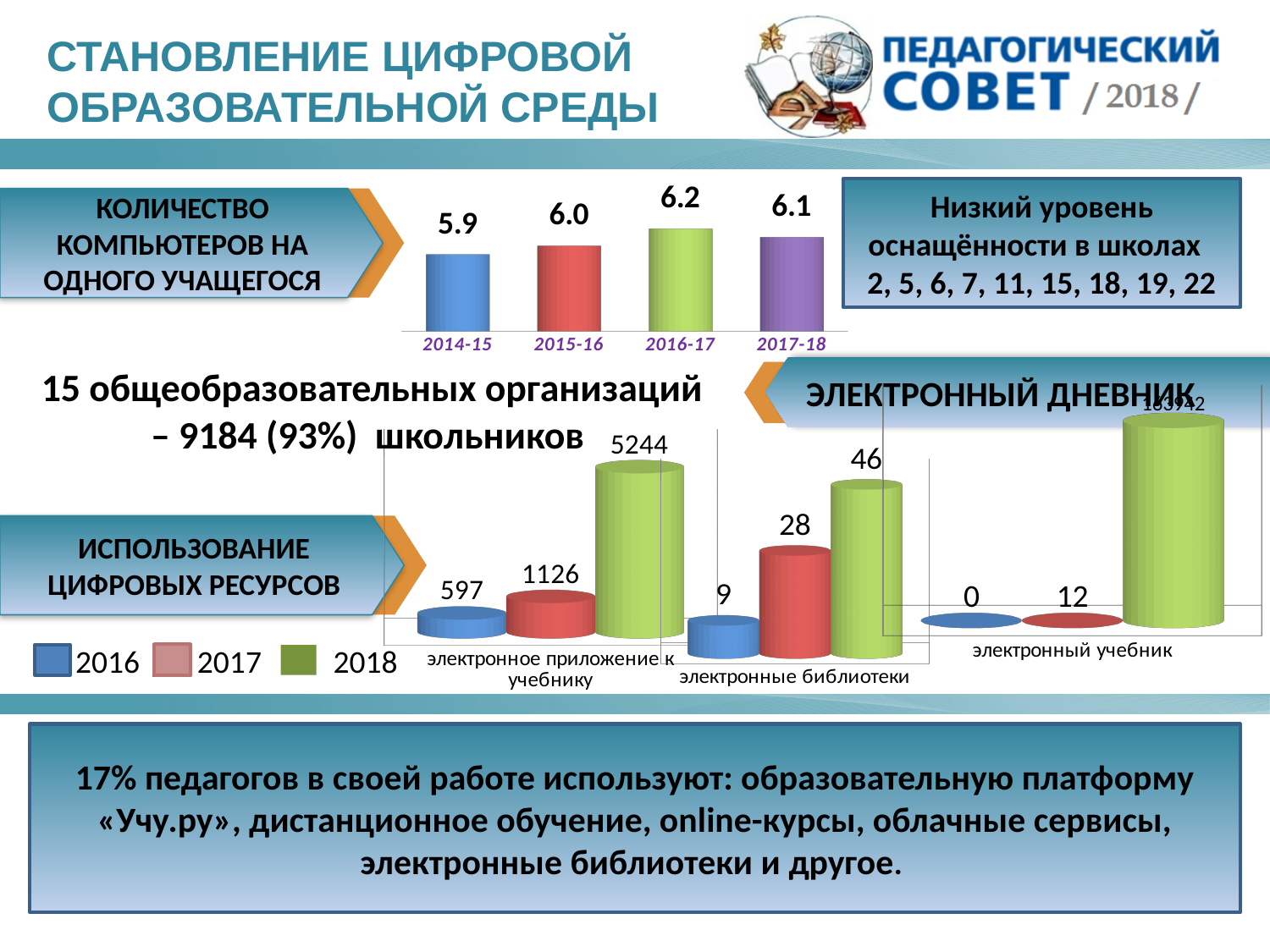
In the chart 'Количество компьютеров на одного учащегося', which year has the lowest value? 2014-15 What kind of chart is 'Количество компьютеров на одного учащегося'? bar chart In the chart 'Использование цифровых ресурсов', what is the difference between the 2017 and 2016 values for 'электронное приложение к учебнику'? 529 In the chart 'Использование цифровых ресурсов', what is the 2017 value for 'электронные библиотеки'? 28 In the chart 'Использование цифровых ресурсов', which colour represents 2018 in the legend? green In the chart 'Использование цифровых ресурсов', what is the 2016 value for 'электронный учебник'? 0 In the chart 'Использование цифровых ресурсов', what is the 2018 value for 'электронное приложение к учебнику'? 5244 In the chart 'Количество компьютеров на одного учащегося', what is the value for 2014-15? 5.9 In the chart 'Количество компьютеров на одного учащегося', what is the value for 2016-17? 6.2 In the chart 'Количество компьютеров на одного учащегося', which year has the highest value? 2016-17 In the chart 'Использование цифровых ресурсов', how many series does the legend list? 3 In the chart 'Количество компьютеров на одного учащегося', how many years are shown? 4